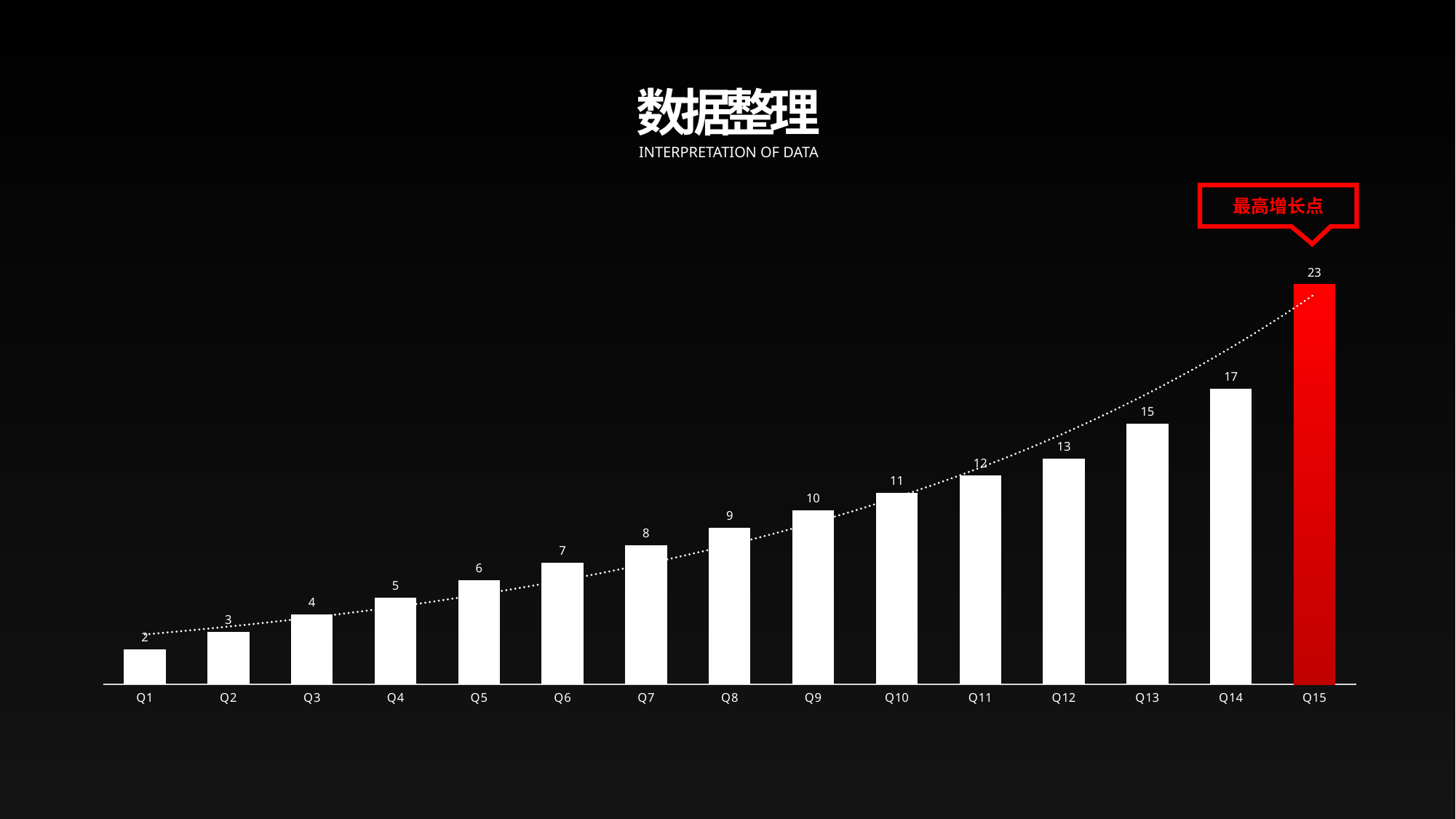
What is the value for Q15? 23 How many quarters are shown on the x axis? 15 What is the value for Q12? 13 What is the difference between the values for Q10 and Q5? 5 Which quarter has the lowest value? Q1 What is the difference between the values for Q15 and Q14? 6 Which bar is coloured red? Q15 What is the value for Q7? 8 Do the values rise or fall from Q1 to Q15? Rise Which quarter has the highest value? Q15 What kind of chart is this? Bar chart Which is larger, the value for Q13 or the value for Q9? Q13